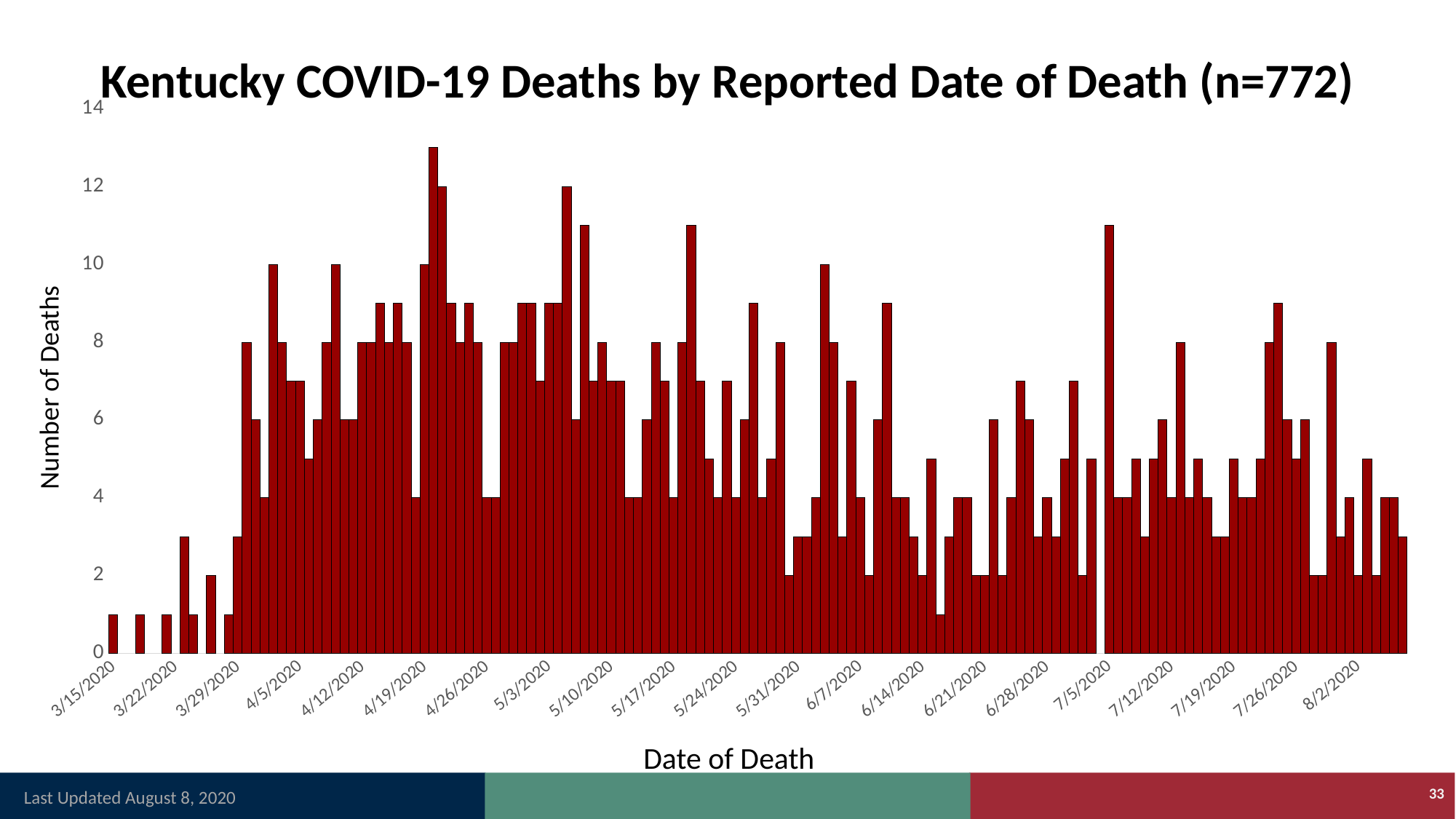
Which is taller, the tallest bar in April or the tallest bar in July? April What kind of chart is shown on the slide? bar chart Is the value of the tallest bar greater or less than 12? greater Do the daily values generally rise or fall from 3/15/2020 to 4/5/2020? rise What is the highest tick value shown on the vertical axis? 14 Is the value for 3/15/2020 greater or less than 2? less What total number of deaths (n) is stated in the chart title? 772 What is the label on the vertical axis of the chart? Number of Deaths In which month does the tallest bar of the chart occur? April What is the title of the chart? Kentucky COVID-19 Deaths by Reported Date of Death (n=772)